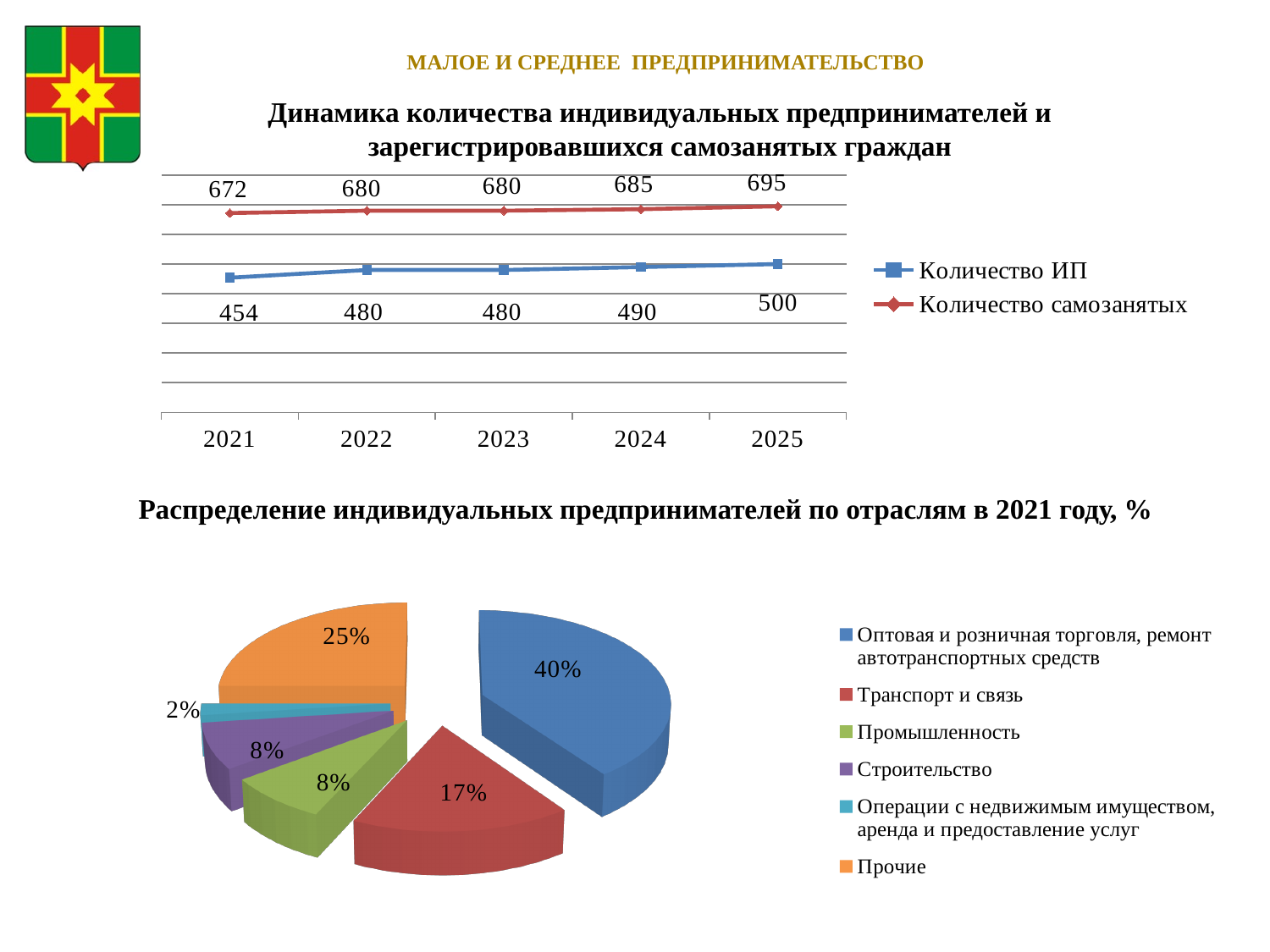
In the top line chart, how many series does the legend list? 2 In the top line chart, what is the value of Количество самозанятых in 2025? 695 In the top line chart, what is the value of Количество ИП in 2021? 454 In the top line chart, in which year is Количество самозанятых lowest? 2021 In the bottom pie chart, what share does Транспорт и связь have? 17% In the top line chart, how many years are shown on the x axis? 5 In the top line chart, in which year is Количество ИП highest? 2025 What type of chart is the bottom chart on the slide? pie chart In the top line chart, does Количество ИП rise or fall from 2021 to 2025? rise In the top line chart, what is the difference between Количество самозанятых and Количество ИП in 2024? 195 In the bottom pie chart, which category has the smallest slice? Операции с недвижимым имуществом, аренда и предоставление услуг In the bottom pie chart, which category has the largest slice? Оптовая и розничная торговля, ремонт автотранспортных средств